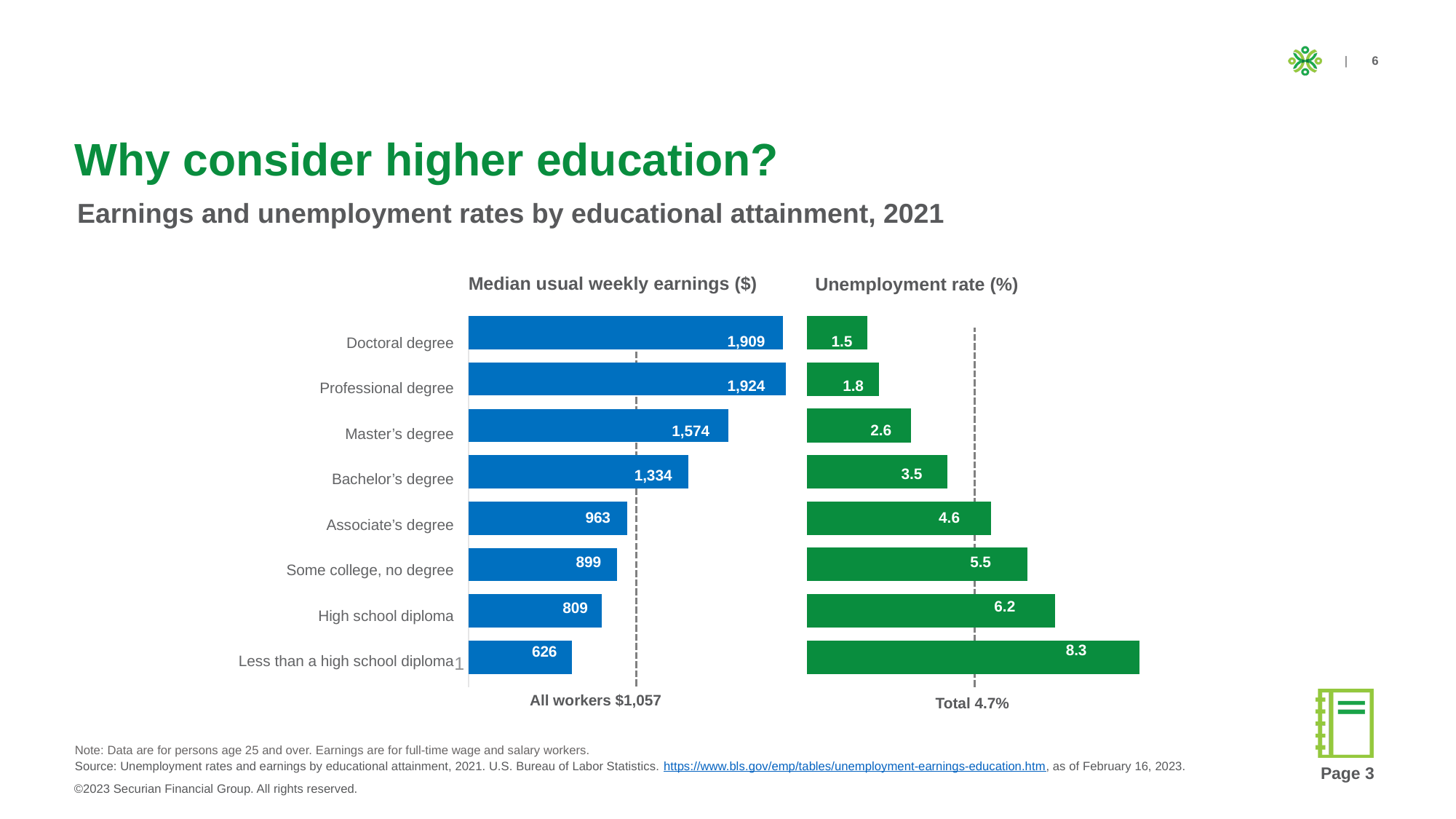
In the Unemployment rate (%) chart, what is the value for Bachelor's degree? 3.5 In the Median usual weekly earnings ($) chart, which is larger: Associate's degree or Some college, no degree? Associate's degree In the Median usual weekly earnings ($) chart, what is the value for Master's degree? 1,574 In the Unemployment rate (%) chart, what is the difference between Less than a high school diploma and Associate's degree? 3.7 In the Unemployment rate (%) chart, which category has the lowest value? Doctoral degree In the Unemployment rate (%) chart, what is the value for Less than a high school diploma? 8.3 In the Median usual weekly earnings ($) chart, which category has the highest value? Professional degree What kind of chart is the Unemployment rate (%) chart? Bar chart What value is shown for All workers below the Median usual weekly earnings ($) chart? $1,057 In the Unemployment rate (%) chart, which is larger: High school diploma or Some college, no degree? High school diploma How many categories are shown in the Median usual weekly earnings ($) chart? 8 In the Median usual weekly earnings ($) chart, what is the difference between Bachelor's degree and High school diploma? 525